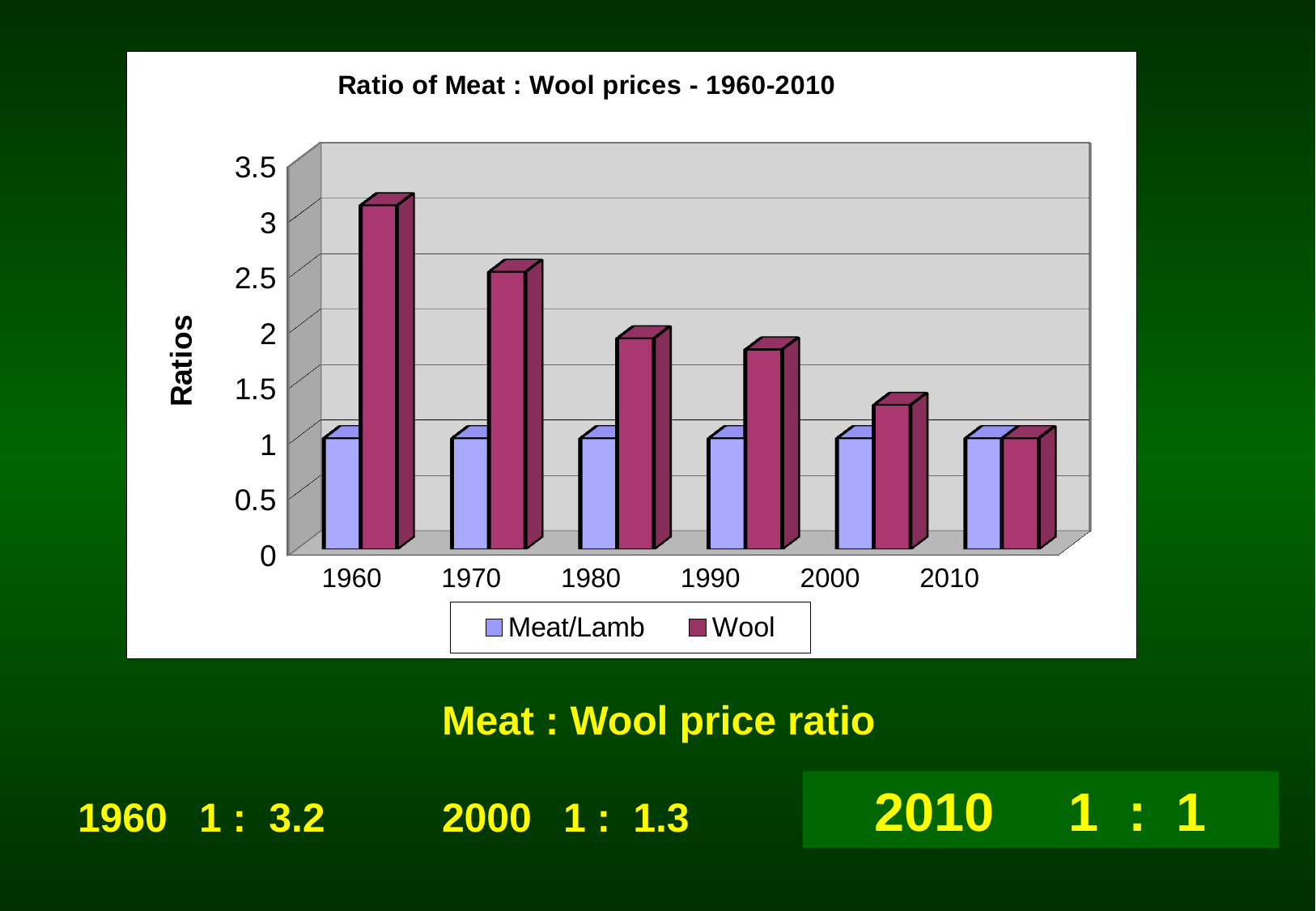
What is the Wool value in 2010? 1 Does the Wool series rise or fall from 1960 to 2010? fall Is the Wool value for 1990 greater or less than 2? less How many series does the chart legend list? 2 What is the title of the chart? Ratio of Meat : Wool prices - 1960-2010 In which year is the Wool bar highest? 1960 How many years are shown on the x axis of the chart? 6 What kind of chart is shown on the slide? bar chart Which is larger, the Wool value in 1970 or the Wool value in 1990? 1970 What is the value of the Meat/Lamb series in 1980? 1 Is the Wool value for 1970 greater or less than 2? greater What is the label of the y axis of the chart? Ratios